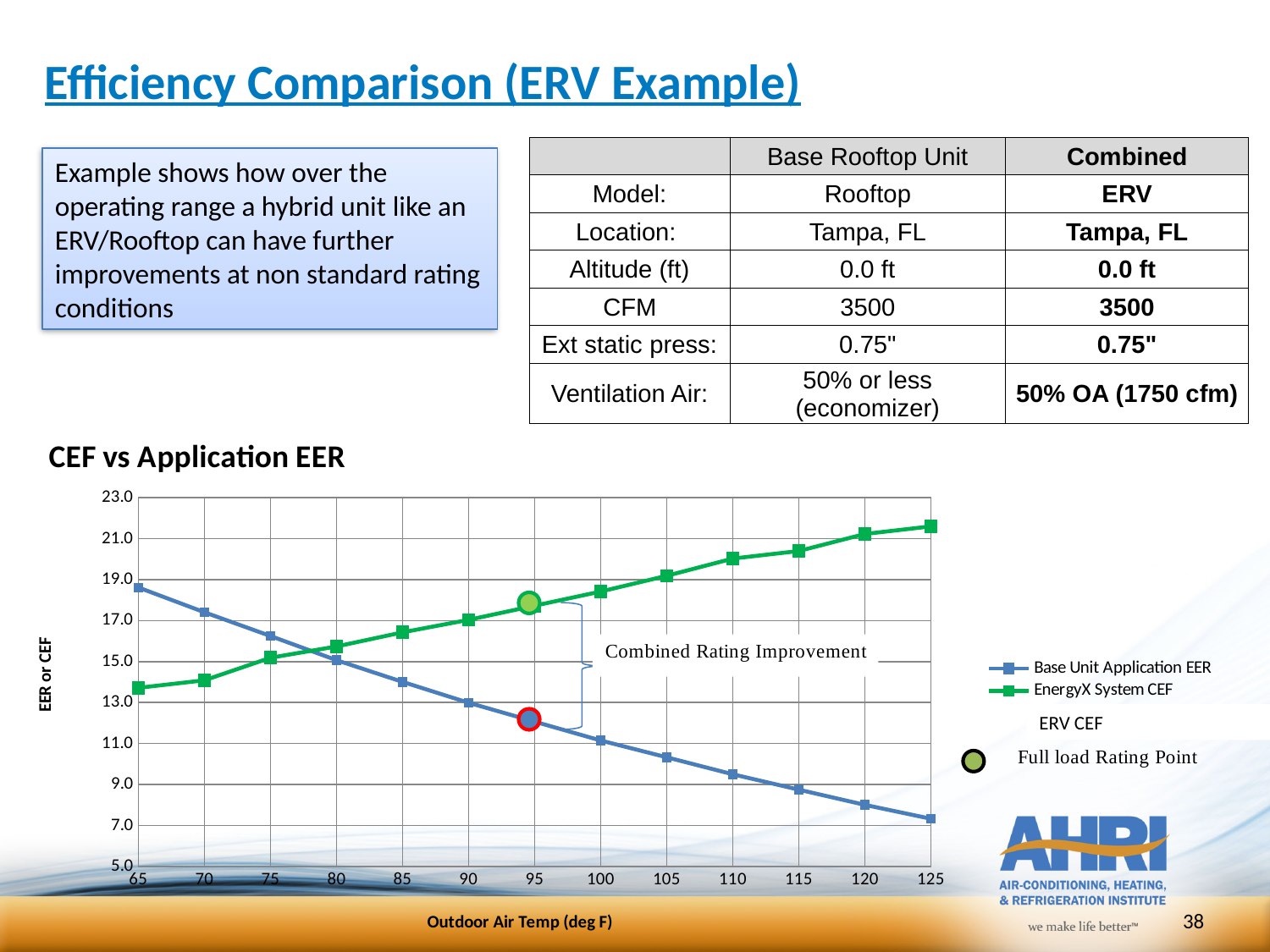
How many series does the legend of the "CEF vs Application EER" chart list? 2 In the "CEF vs Application EER" chart, does the Base Unit Application EER rise or fall as outdoor air temperature increases? fall At which outdoor air temperature is the Base Unit Application EER highest? 65 Is the Base Unit Application EER at 125 deg F greater or less than 9.0? less In the "CEF vs Application EER" chart, does the EnergyX System CEF rise or fall as outdoor air temperature increases? rise Is the EnergyX System CEF at 65 deg F greater or less than 15.0? less At 125 deg F, which series has the higher value: Base Unit Application EER or EnergyX System CEF? EnergyX System CEF What is the x-axis title of the "CEF vs Application EER" chart? Outdoor Air Temp (deg F) At which outdoor air temperature is the EnergyX System CEF lowest? 65 Is the Base Unit Application EER at 65 deg F greater or less than 17.0? greater What type of chart is shown under the title "CEF vs Application EER"? line chart How many outdoor air temperature points are plotted for each series in the "CEF vs Application EER" chart? 13